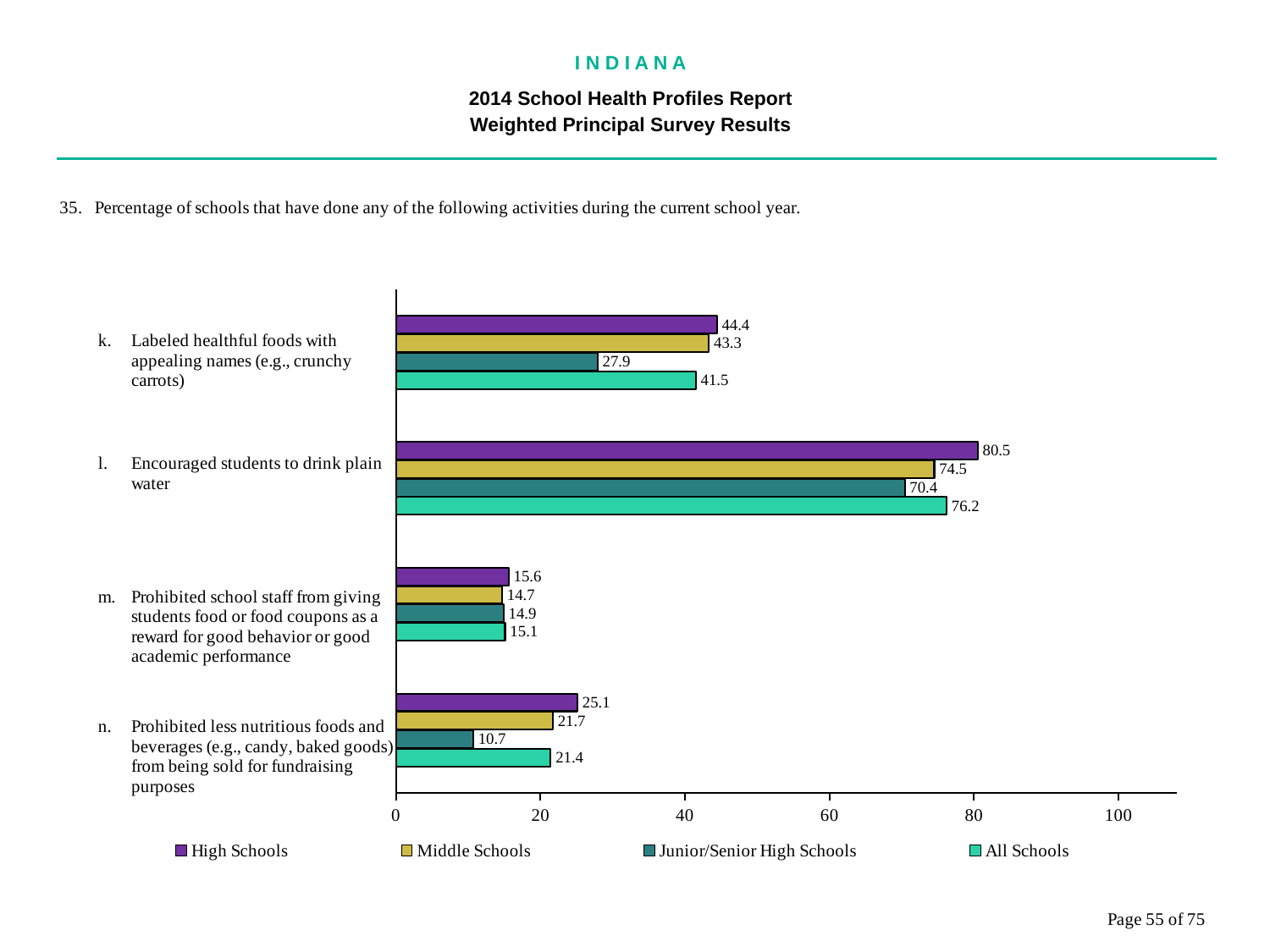
What is the value for High Schools for 'Encouraged students to drink plain water'? 80.5 What is the difference between the High Schools and Junior/Senior High Schools values for 'Encouraged students to drink plain water'? 10.1 Is the All Schools value for 'Encouraged students to drink plain water' greater or less than 60? greater What is the value for All Schools for 'Prohibited less nutritious foods and beverages (e.g., candy, baked goods) from being sold for fundraising purposes'? 21.4 Which series is shown in purple in the legend? High Schools Which category has the highest value for Middle Schools? Encouraged students to drink plain water How many categories (activities) are shown on the chart? 4 How many series does the legend list? 4 For 'Prohibited less nutritious foods and beverages (e.g., candy, baked goods) from being sold for fundraising purposes', which is larger: the High Schools value or the Middle Schools value? High Schools What kind of chart is shown on the slide? Bar chart What is the value for Junior/Senior High Schools for 'Labeled healthful foods with appealing names (e.g., crunchy carrots)'? 27.9 Which category has the lowest value for All Schools? Prohibited school staff from giving students food or food coupons as a reward for good behavior or good academic performance